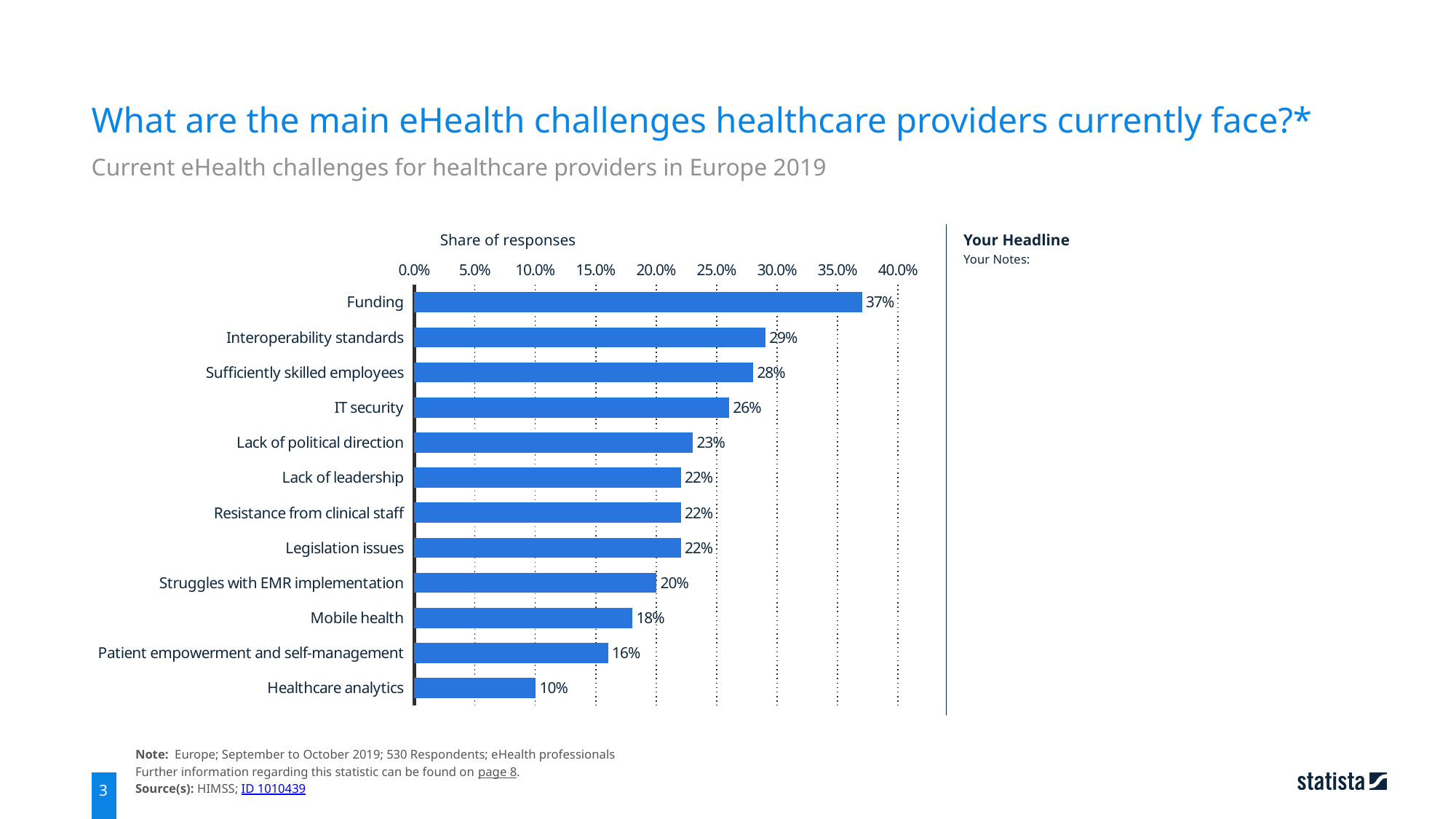
What is the difference in share of responses between Funding and Interoperability standards? 8% Is the share of responses for Patient empowerment and self-management greater or less than 20.0%? less What kind of chart is shown on the slide? Bar chart Which challenge has the highest share of responses? Funding How many challenges are shown in the chart? 12 What is the share of responses for Funding? 37% Which challenge has the lowest share of responses? Healthcare analytics What is the share of responses for IT security? 26% Which has a larger share of responses, Sufficiently skilled employees or Lack of political direction? Sufficiently skilled employees What is the difference in share of responses between Struggles with EMR implementation and Healthcare analytics? 10% What is the share of responses for Mobile health? 18% What is the label of the value axis of the chart? Share of responses